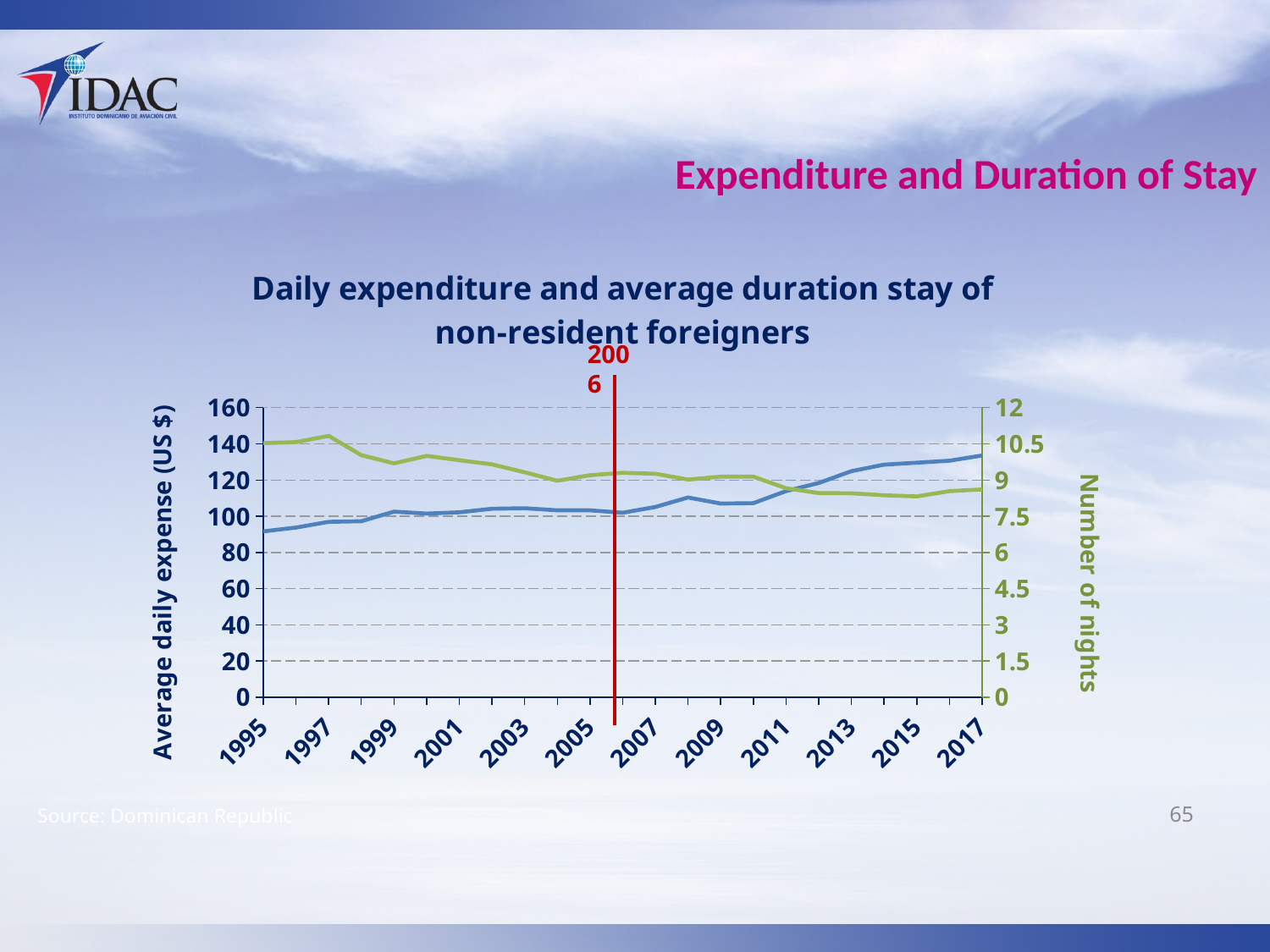
In which year is the average daily expense (blue line) lowest? 1995 Is the number of nights in 2017 greater or less than 9? less How many years are labelled on the x axis? 12 What is the title of the right-hand vertical axis? Number of nights Is the average daily expense in 2017 greater or less than 120? greater What kind of chart is shown on the slide? Line chart Which year has the larger number of nights, 1995 or 2017? 1995 Does the number of nights (green line) rise or fall overall from 1995 to 2017? Fall Is the average daily expense in 1995 greater or less than 100? less In which year is the number of nights (green line) highest? 1997 What is the title of the chart? Daily expenditure and average duration stay of non-resident foreigners Does the average daily expense (blue line) rise or fall overall from 1995 to 2017? Rise